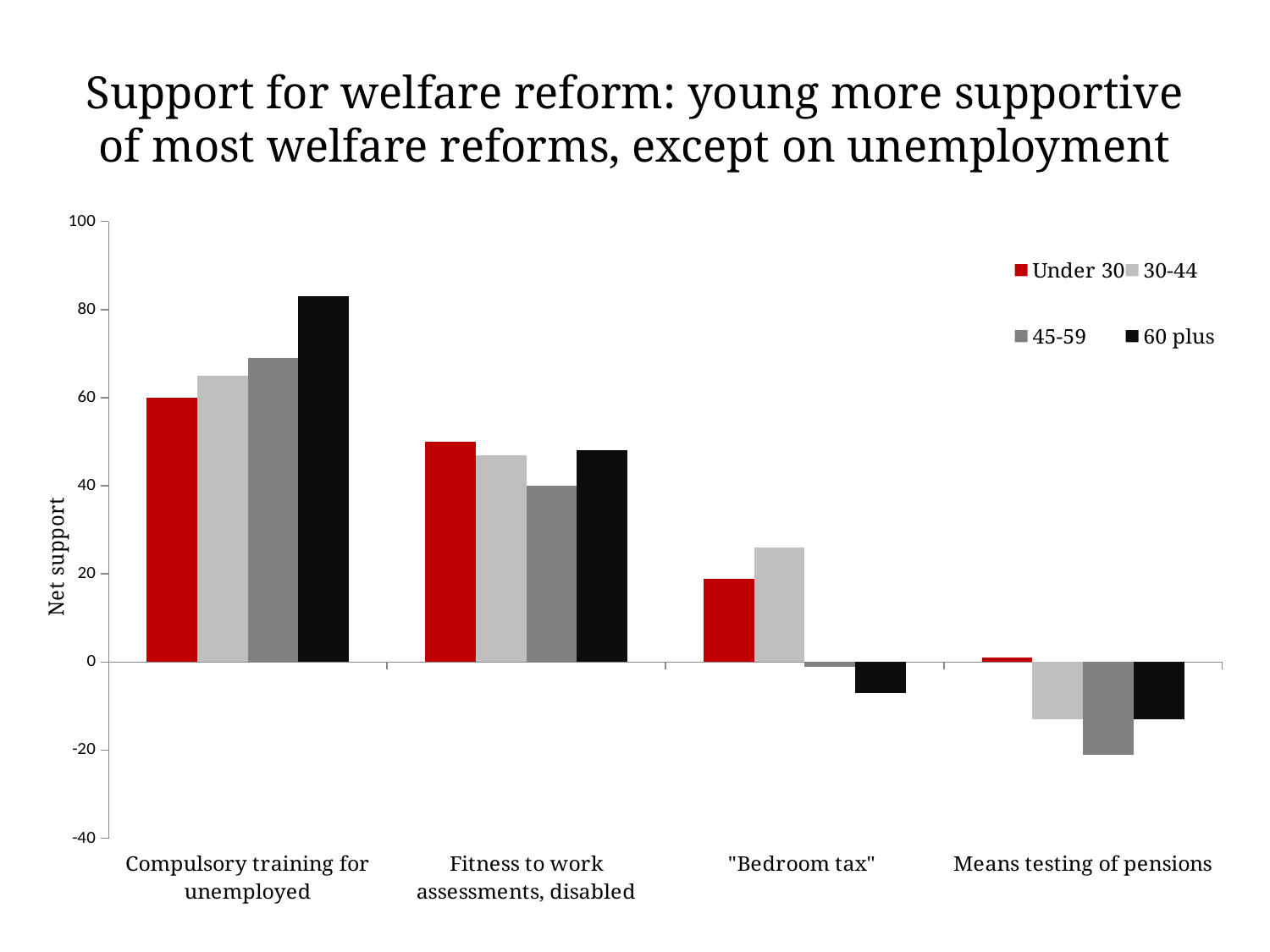
What is the label on the vertical axis? Net support What is the net support of the Under 30 group for compulsory training for unemployed? 60 Which age group shows the lowest net support for means testing of pensions? 45-59 For the "Bedroom tax", which has higher net support: Under 30 or 30-44? 30-44 Which age group shows the highest net support for compulsory training for unemployed? 60 plus Is the net support of the 60 plus group for compulsory training for unemployed greater or less than 80? greater What is the net support of the 45-59 group for fitness to work assessments, disabled? 40 How many welfare reform categories are shown on the x axis? 4 Do the values for the 60 plus group rise or fall moving left to right across the categories? fall Is the net support of the 30-44 group for the "Bedroom tax" greater or less than 20? greater How many series does the legend list? 4 What kind of chart is shown on the slide? bar chart